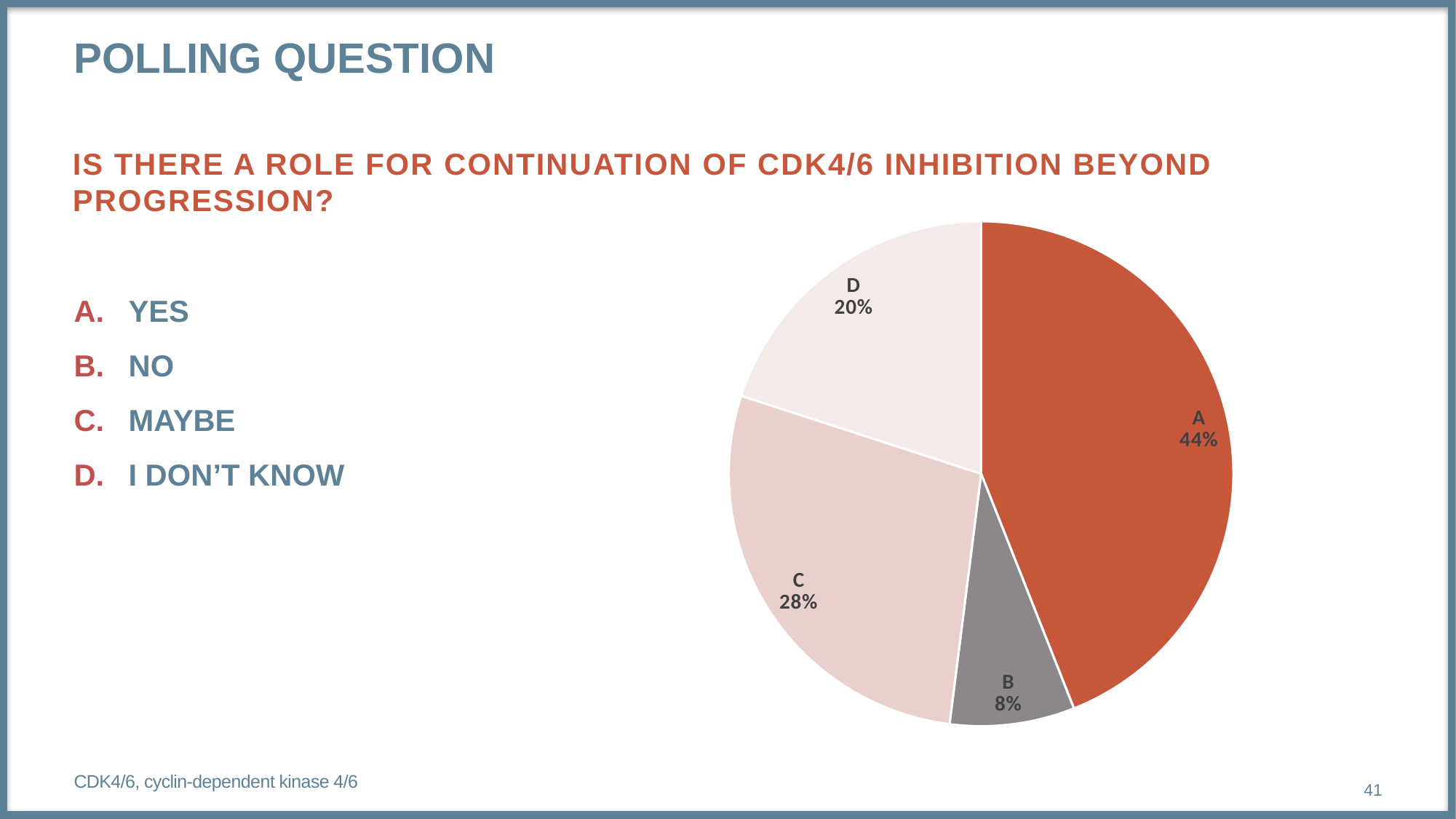
How many slices does the pie chart have? 4 What percentage of responses does slice B represent? 8% Which is larger, slice C or slice D? C What percentage of responses does slice A represent? 44% What percentage of responses does slice D represent? 20% Which slice of the pie chart is the smallest? B Which slice of the pie chart is the largest? A What colour is slice A in the pie chart? orange-red What is the combined share of slices B and D? 28% What percentage of responses does slice C represent? 28% What is the difference in percentage points between slice A and slice C? 16 What kind of chart is shown on the slide? pie chart